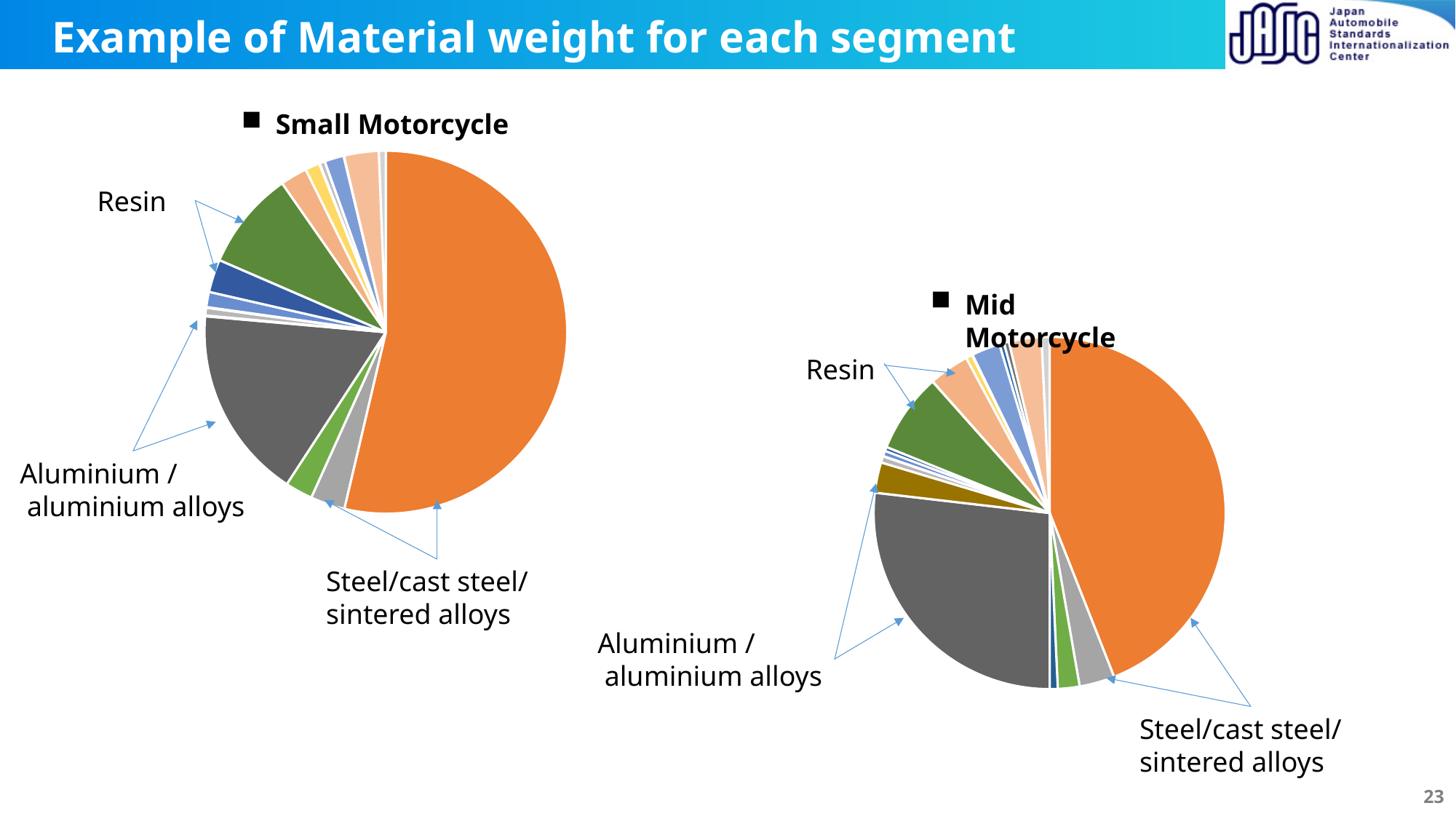
In the Small Motorcycle chart, which slice is larger: Resin or Aluminium / aluminium alloys? Aluminium / aluminium alloys In the Mid Motorcycle chart, which slice is larger: Steel/cast steel/sintered alloys or Aluminium / aluminium alloys? Steel/cast steel/sintered alloys How many pie charts are shown on the slide? 2 In the Mid Motorcycle chart, which labelled material has the largest slice? Steel/cast steel/sintered alloys What kind of chart is the Mid Motorcycle chart? pie chart What is the title of the slide containing the two pie charts? Example of Material weight for each segment In the Mid Motorcycle chart, which slice is larger: Aluminium / aluminium alloys or Resin? Aluminium / aluminium alloys What kind of chart is the Small Motorcycle chart? pie chart In the Small Motorcycle chart, which labelled material has the largest slice? Steel/cast steel/sintered alloys